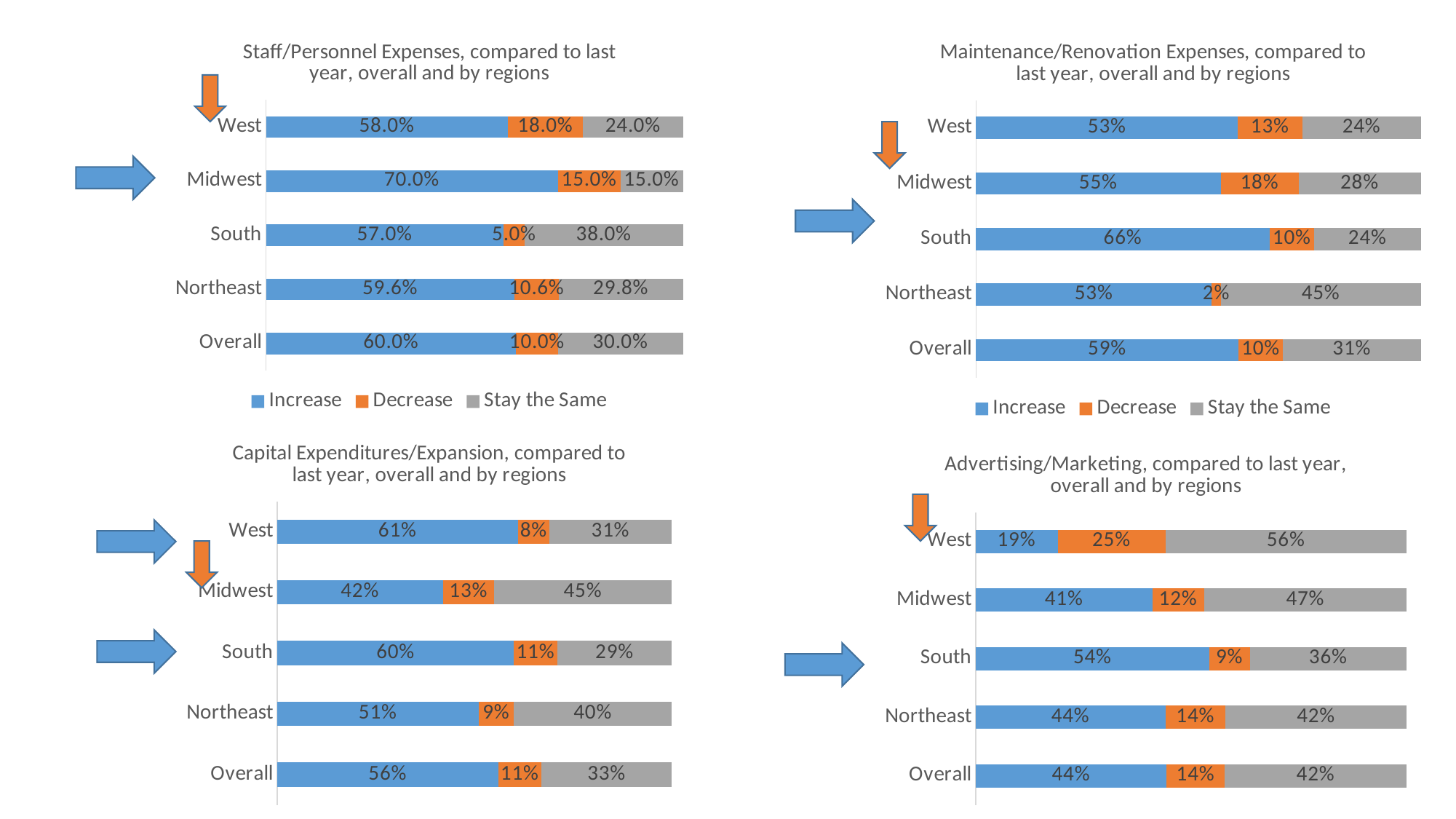
How many series does the legend of the Staff/Personnel Expenses chart list? 3 What kind of chart is the Advertising/Marketing chart? Stacked bar chart In the Advertising/Marketing chart, which region has the highest Decrease percentage? West In the Staff/Personnel Expenses chart, what percentage of the Midwest reported an Increase? 70.0% In the Maintenance/Renovation Expenses chart, what is the Decrease percentage for the Northeast? 2% In the Staff/Personnel Expenses chart, which region has the highest Stay the Same percentage? South In the Capital Expenditures/Expansion chart, what is the Stay the Same percentage for the Midwest? 45% In the Maintenance/Renovation Expenses chart, which region has the lowest Decrease percentage? Northeast In the Advertising/Marketing chart, what is the total of the three segments for the West bar? 100% In the Maintenance/Renovation Expenses chart, is the Increase percentage larger for South or Midwest? South In the Capital Expenditures/Expansion chart, which region has the lowest Increase percentage? Midwest In the Staff/Personnel Expenses chart, what is the difference between the Increase percentages for Midwest and South? 13.0%